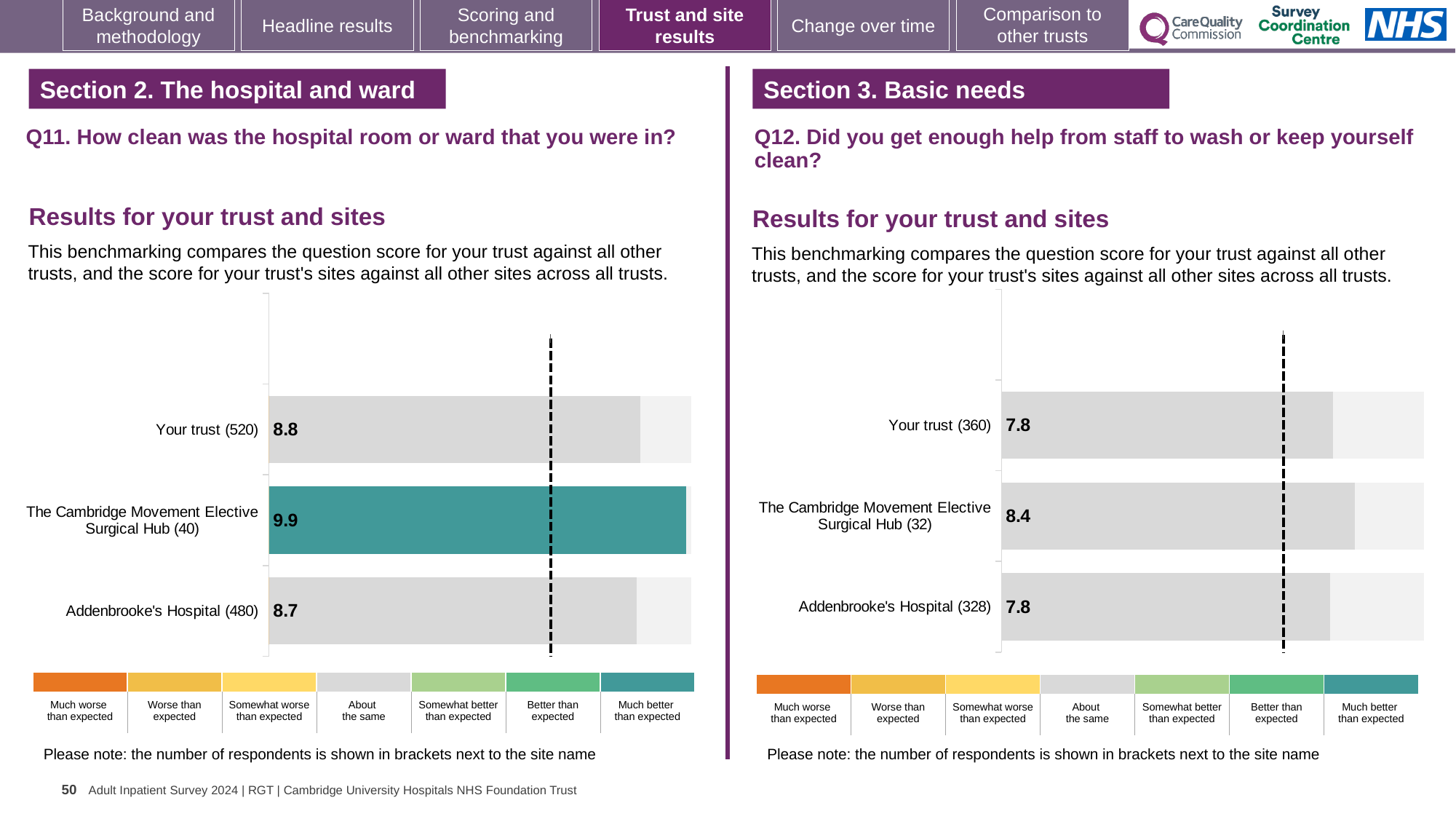
On the Q12 chart (right), what is the score for Addenbrooke's Hospital (328)? 7.8 On the Q11 chart (left), what is the score for Addenbrooke's Hospital (480)? 8.7 On the Q12 chart (right), what is the score for Your trust (360)? 7.8 On the Q11 chart (left), what is the score for Your trust (520)? 8.8 On the Q12 chart (right), what is the score for The Cambridge Movement Elective Surgical Hub (32)? 8.4 What type of chart is used on the Q11 chart (left)? Bar chart On the Q11 chart (left), how many bars are plotted? 3 On the Q12 chart (right), which site has the highest score? The Cambridge Movement Elective Surgical Hub (32) On the Q11 chart (left), which site or trust has the highest score? The Cambridge Movement Elective Surgical Hub (40) On the Q12 chart (right), what is the difference between the scores for The Cambridge Movement Elective Surgical Hub and Your trust? 0.6 On the Q11 chart (left), what is the score for The Cambridge Movement Elective Surgical Hub (40)? 9.9 On the Q11 chart (left), what is the difference between the scores for The Cambridge Movement Elective Surgical Hub and Addenbrooke's Hospital? 1.2